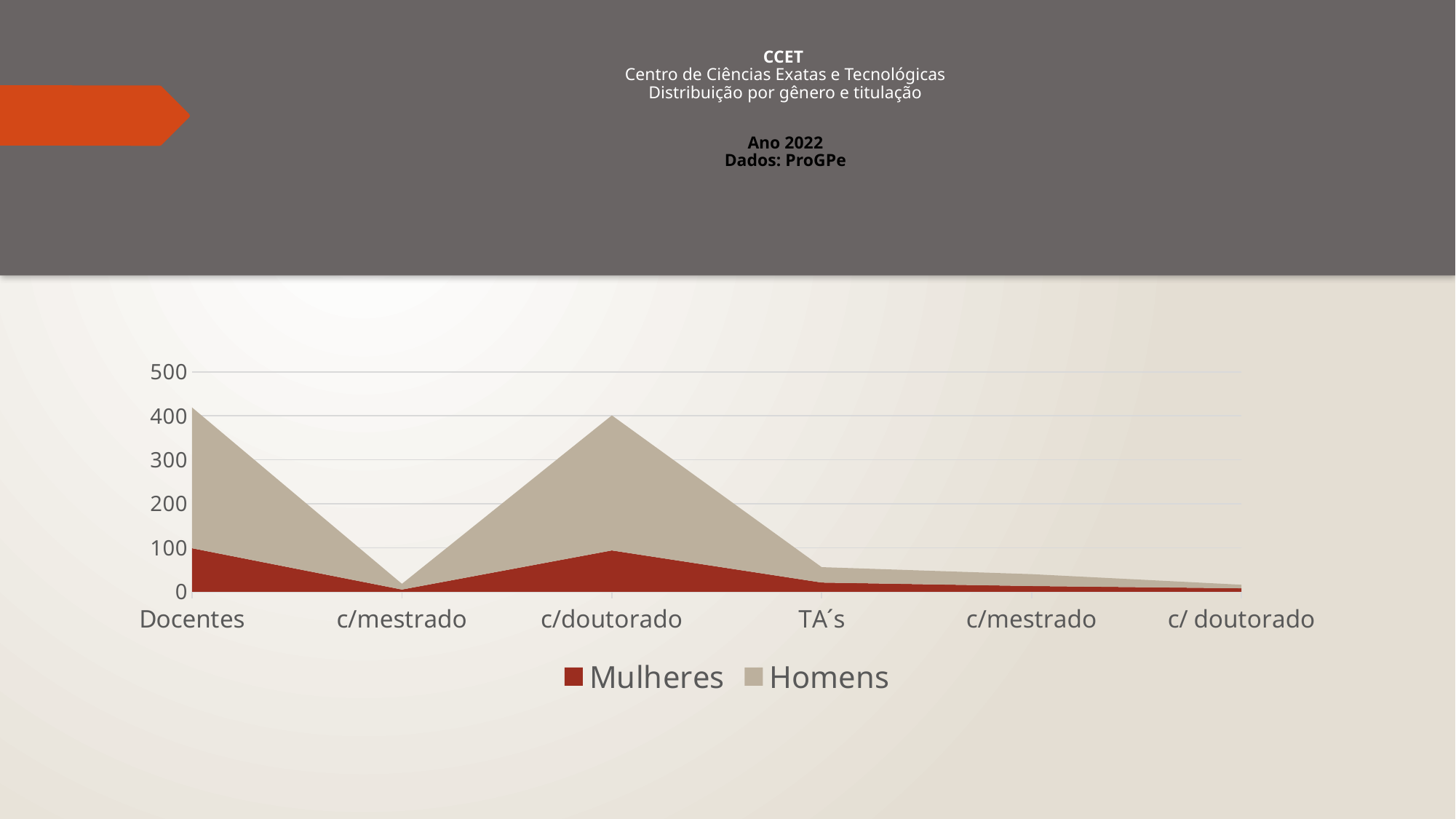
What kind of chart is shown on the slide? Area chart Which colour represents the Mulheres series in the chart? Dark red Is the stacked total (Mulheres plus Homens) at Docentes greater or less than 300? greater Is the stacked total (Mulheres plus Homens) at TA´s greater or less than 100? less What are the two series named in the legend? Mulheres and Homens Is the stacked total (Mulheres plus Homens) at c/doutorado (third category) greater or less than 300? greater Which is larger: the value for Mulheres at Docentes or the value for Mulheres at TA´s? Docentes How many series does the chart legend list? 2 Which is larger: the stacked total at Docentes or the stacked total at TA´s? Docentes How many categories are shown along the x axis? 6